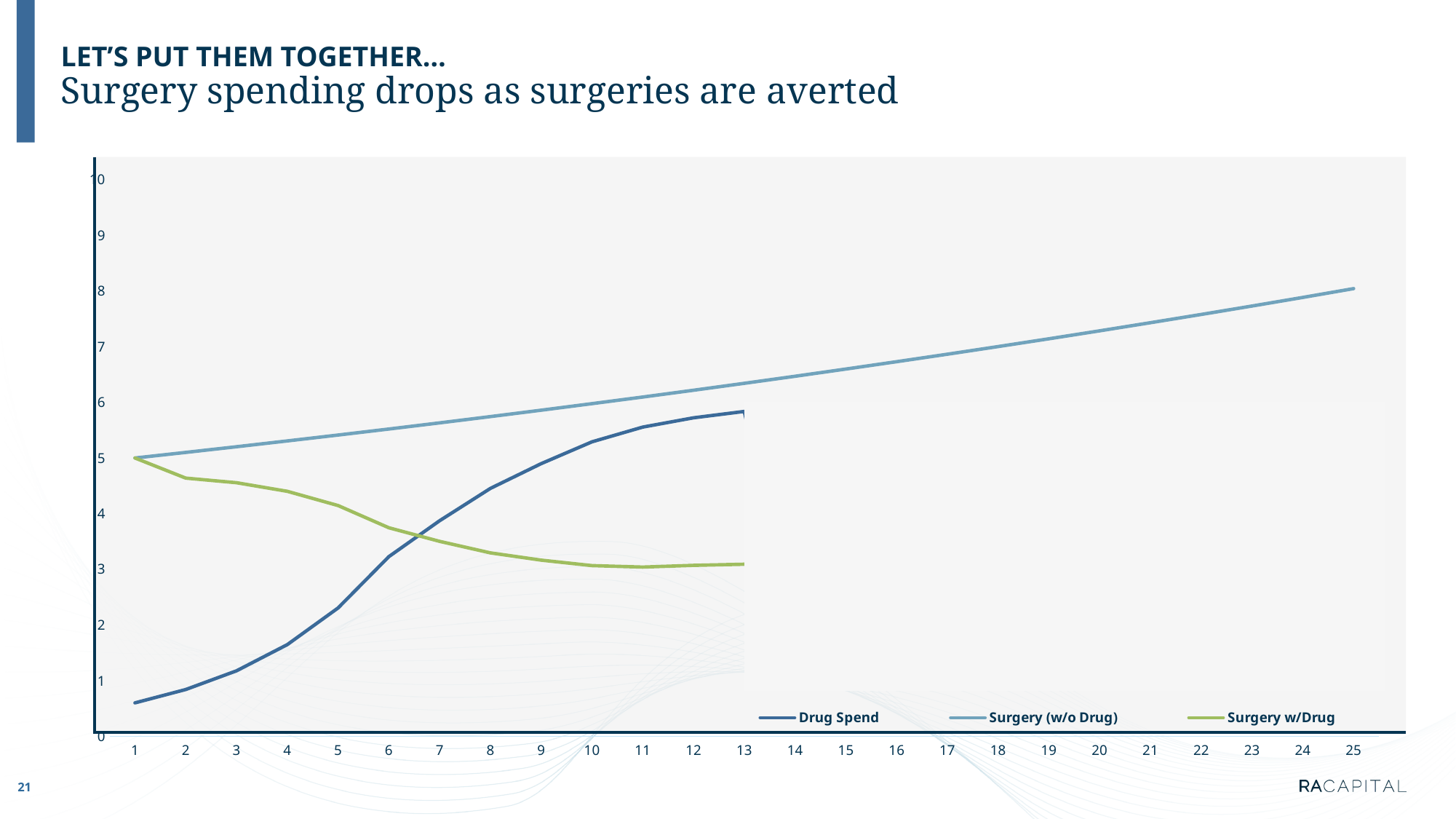
Is the value for Drug Spend at x = 13 greater or less than 5? greater Is the value for Surgery w/Drug at x = 13 greater or less than 4? less Is the value for Surgery (w/o Drug) at x = 25 greater or less than 7? greater How many series does the legend list? 3 What kind of chart is shown on the slide? line chart Which series has the highest value at x = 13? Surgery (w/o Drug) What is the value of Surgery w/Drug at x = 1? 5 Does the Drug Spend line rise or fall as x increases? rise How many points are labelled along the x axis? 25 Does the Surgery w/Drug line rise or fall as x increases? fall At x = 13, which is larger: Drug Spend or Surgery w/Drug? Drug Spend